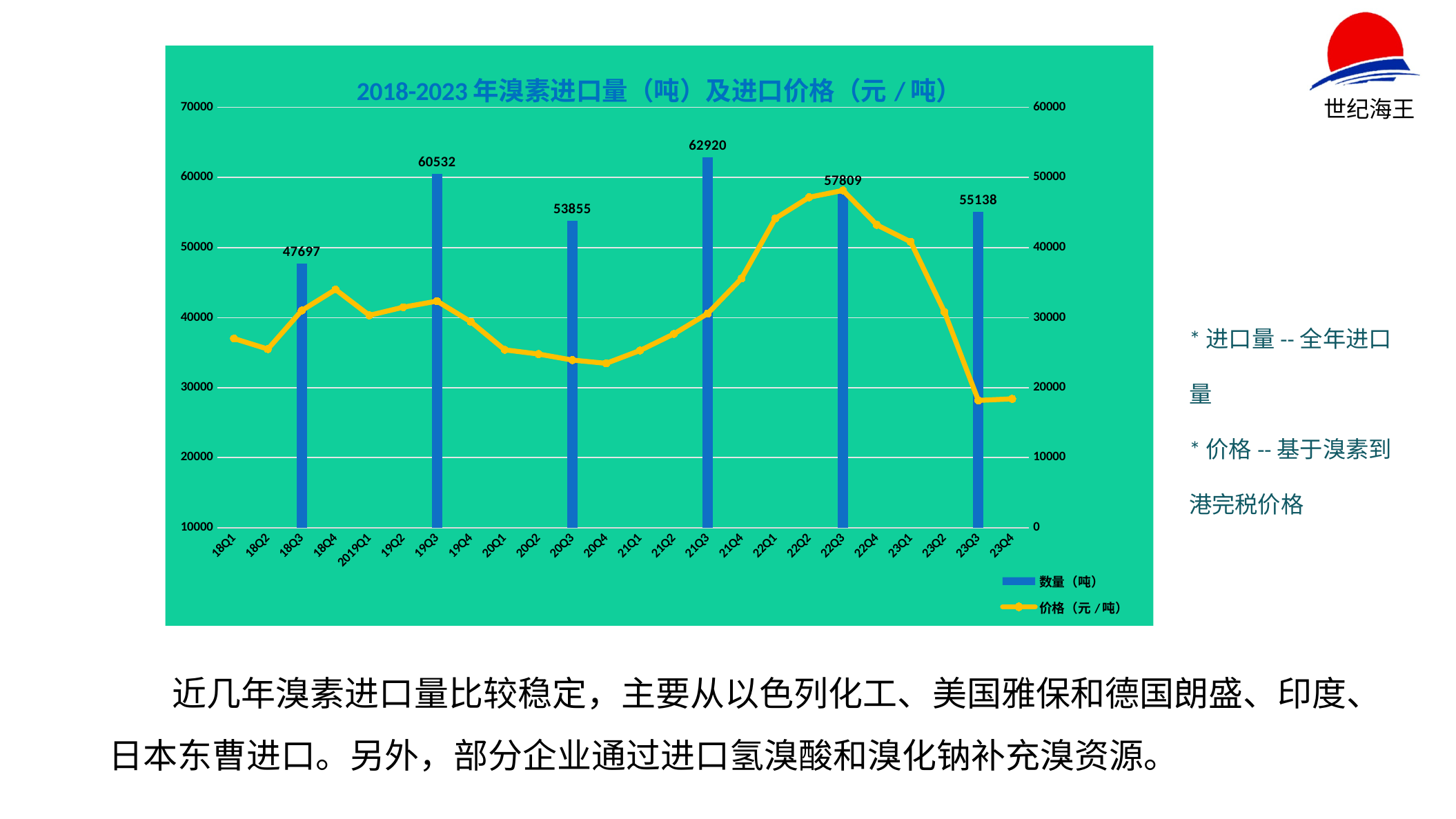
What is the import quantity (数量) for 23Q3? 55138 Which quarter has the lowest import quantity bar? 18Q3 What is the import quantity (数量) for 21Q3? 62920 Which is larger, the import quantity for 22Q3 or for 20Q3? 22Q3 Is the price (价格) value for 23Q4 greater or less than 20000 on the right axis? less How many series does the legend list? 2 What is the difference between the import quantity for 21Q3 and 19Q3? 2388 Does the price line rise or fall from 22Q3 to 23Q3? fall Which quarter has the highest import quantity bar? 21Q3 How many import quantity bars are plotted on the chart? 6 Is the price (价格) value for 22Q3 greater or less than 40000 on the right axis? greater What is the import quantity (数量) for 18Q3? 47697